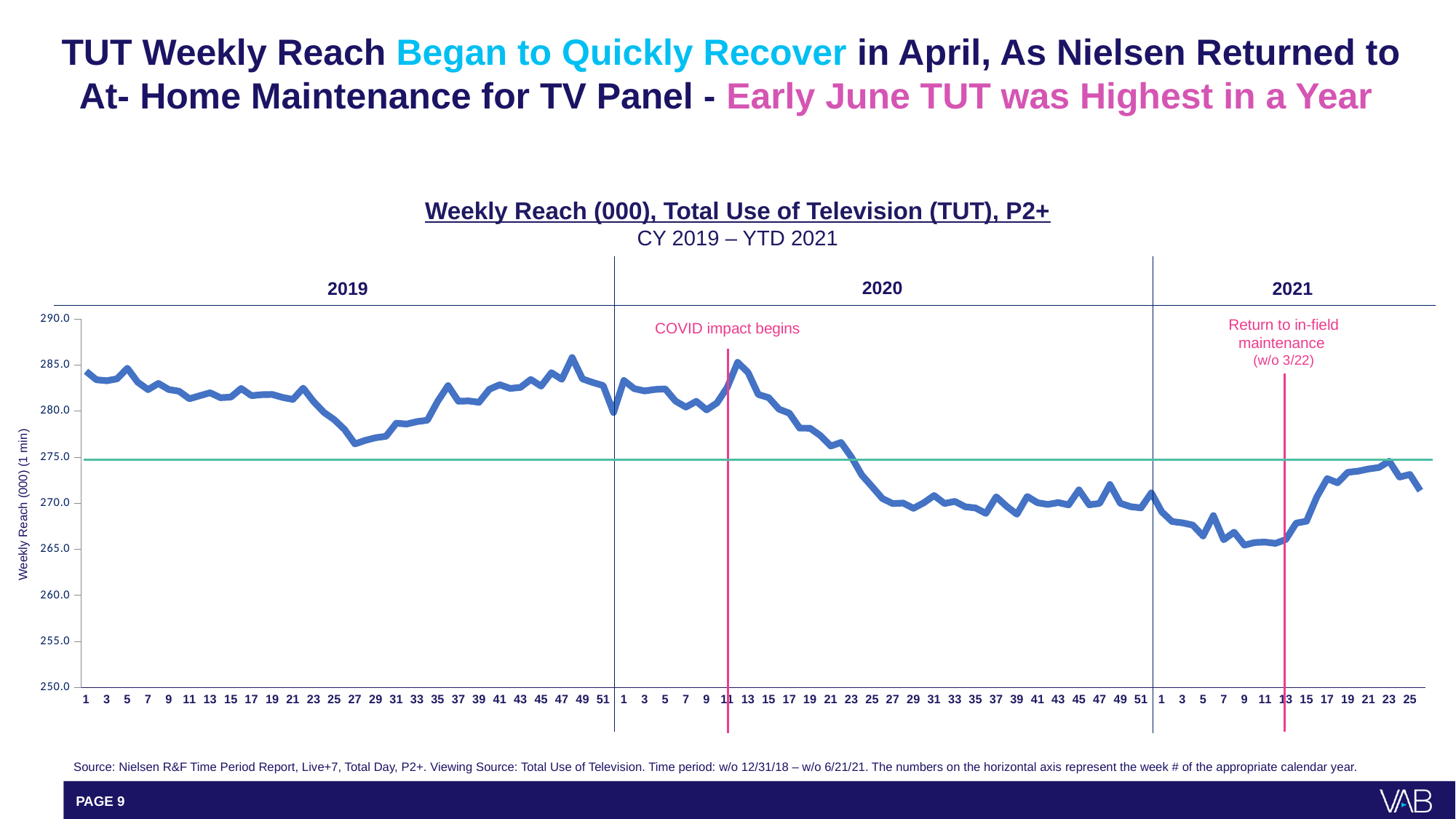
Is the weekly reach value for week 27 of 2020 greater or less than 275.0? less Is the weekly reach value for week 11 of 2021 greater or less than 270.0? less What kind of chart is shown on the slide? line chart What annotation is placed at the vertical line near week 11 of 2020? COVID impact begins Between week 13 and week 27 of 2020, does the weekly reach rise or fall? fall What is the title of the chart? Weekly Reach (000), Total Use of Television (TUT), P2+ Between week 13 and week 23 of 2021, does the weekly reach rise or fall? rise Is the weekly reach value for week 27 of 2019 greater or less than 280.0? less How many calendar years are labeled across the top of the chart? 3 Which is larger: the weekly reach for week 47 of 2019 or for week 27 of 2020? week 47 of 2019